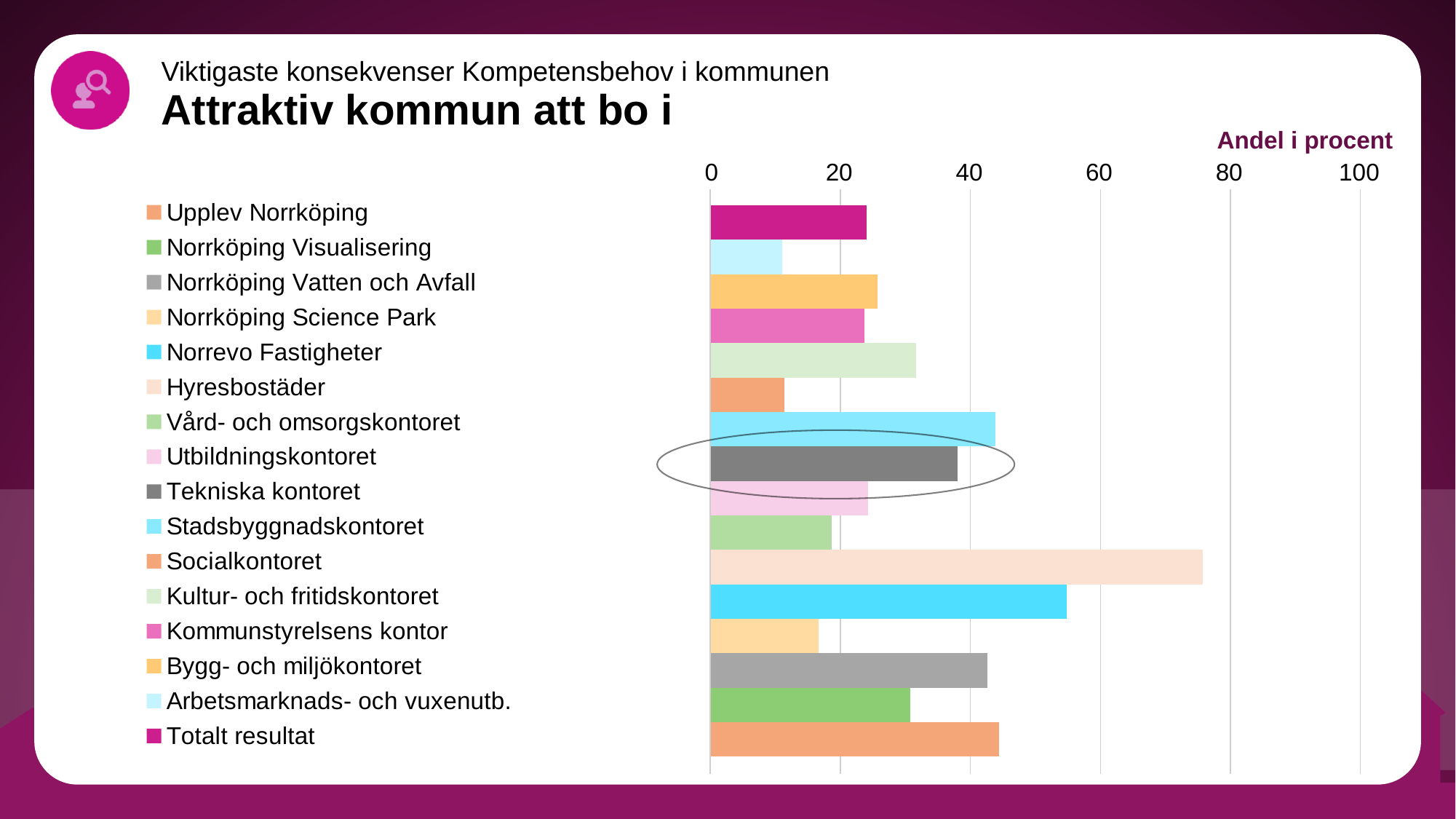
Which is larger, the value for Norrevo Fastigheter or the value for Tekniska kontoret? Norrevo Fastigheter Is the value for Stadsbyggnadskontoret greater or less than 40? greater Which category has the longest bar? Hyresbostäder What kind of chart is shown on the slide? bar chart Is the value for Totalt resultat greater or less than 40? less Which category's bar is circled on the chart? Tekniska kontoret Is the value for Norrevo Fastigheter greater or less than 40? greater Which is larger, the value for Hyresbostäder or the value for Norrevo Fastigheter? Hyresbostäder What is the label shown above the horizontal axis? Andel i procent How many categories does the legend list? 16